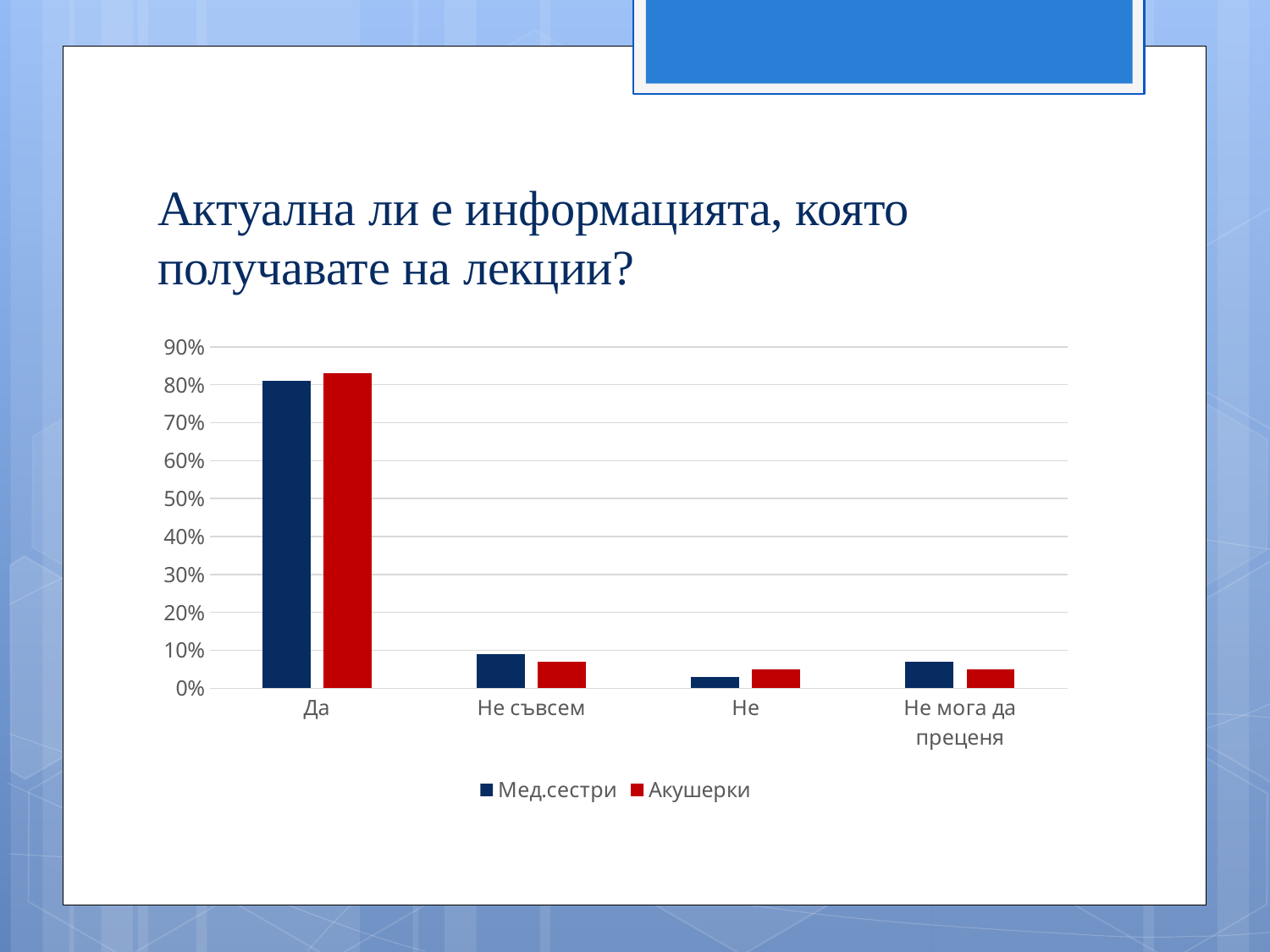
How many answer categories are shown on the x axis? 4 In the Не съвсем category, which series has the larger value, Мед.сестри or Акушерки? Мед.сестри In the Не category, which series has the larger value, Мед.сестри or Акушерки? Акушерки Which colour represents the Акушерки series? red Is the value for Мед.сестри in the Да category greater or less than 70%? greater How many series does the legend list? 2 What kind of chart is shown on the slide? bar chart Which category has the highest value for Акушерки? Да Which category has the highest value for Мед.сестри? Да Is the value for Акушерки in the Да category greater or less than 80%? greater Which category has the lowest value for Мед.сестри? Не